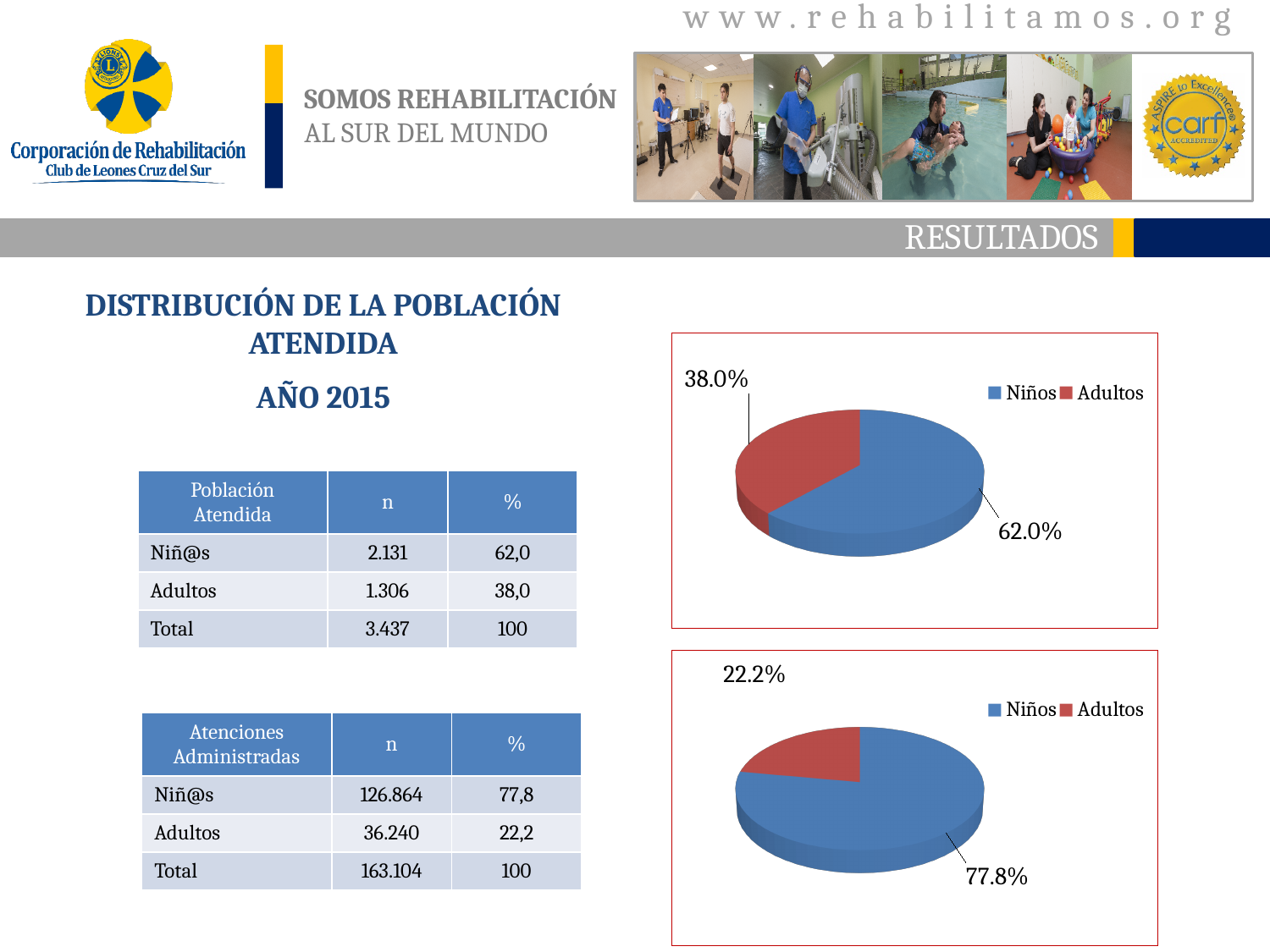
In the bottom pie chart, which category has the smallest slice? Adultos In the top pie chart, what percentage is shown for Adultos? 38.0% In the top pie chart, which category has the largest slice? Niños In the bottom pie chart, which is larger, the Niños slice or the Adultos slice? Niños What type of chart is the bottom chart on the slide? Pie chart How many slices does the top pie chart have? 2 In the top pie chart, what colour represents Adultos? Red In the bottom pie chart, what percentage is shown for Niños? 77.8% In the bottom pie chart, what percentage is shown for Adultos? 22.2% In the bottom pie chart, what is the difference in percentage points between Niños and Adultos? 55.6 In the top pie chart, what is the difference in percentage points between Niños and Adultos? 24.0 In the top pie chart, what percentage is shown for Niños? 62.0%